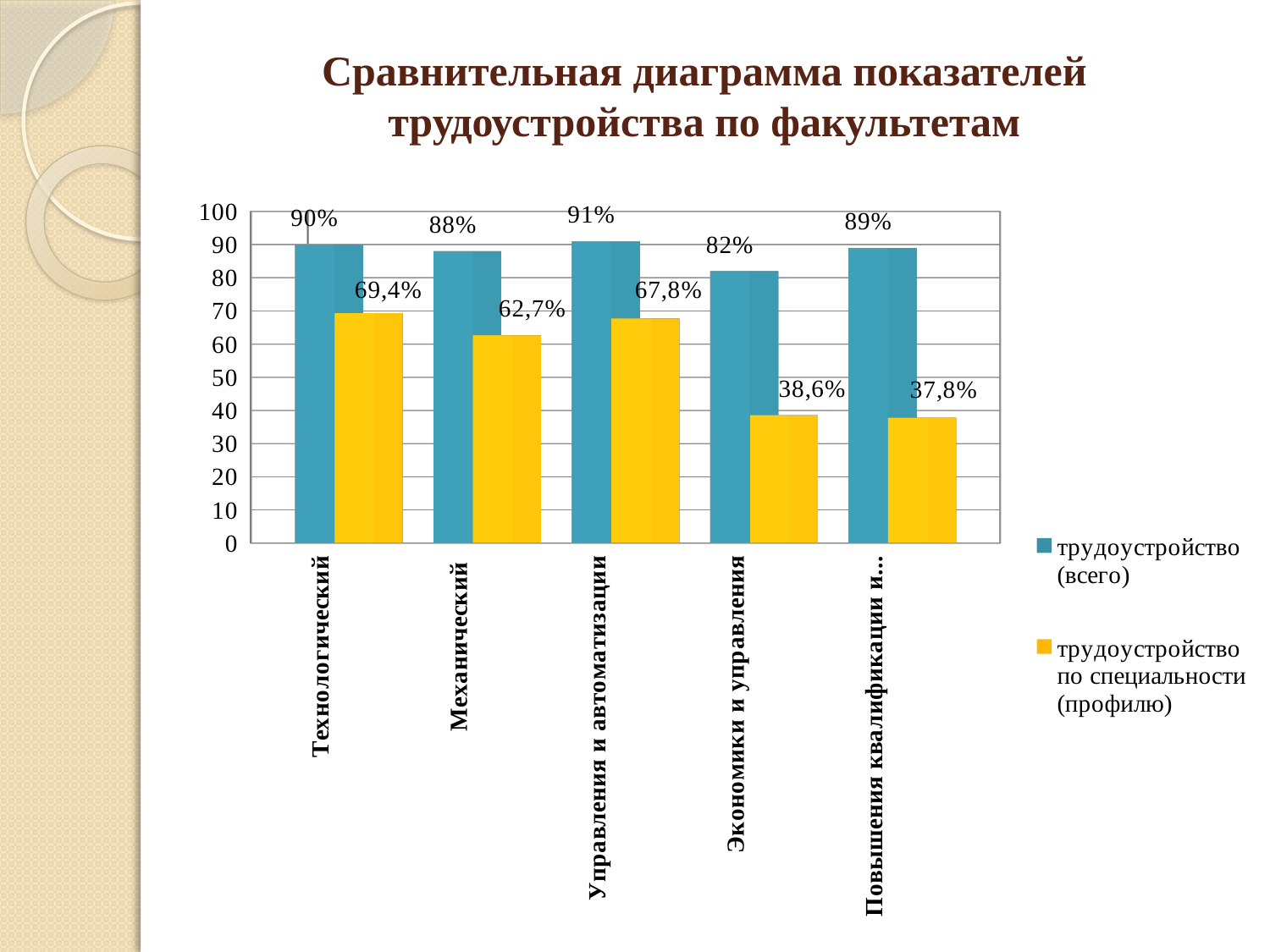
Which faculty has the lowest value for 'трудоустройство (всего)'? Экономики и управления What is the value of 'трудоустройство (всего)' for the Технологический faculty? 90% What is the value of 'трудоустройство по специальности (профилю)' for the Механический faculty? 62,7% How many faculties (categories) are shown on the x axis? 5 What is the difference between 'трудоустройство (всего)' and 'трудоустройство по специальности (профилю)' for the Управления и автоматизации faculty? 23,2% What is the title of the chart on the slide? Сравнительная диаграмма показателей трудоустройства по факультетам How many series does the legend list? 2 What type of chart is shown on the slide? bar chart What is the value of 'трудоустройство по специальности (профилю)' for the Экономики и управления faculty? 38,6% Which faculty has the highest value for 'трудоустройство по специальности (профилю)'? Технологический Which faculty has the highest value for 'трудоустройство (всего)'? Управления и автоматизации Which is larger: 'трудоустройство по специальности (профилю)' for Технологический or for Механический? Технологический